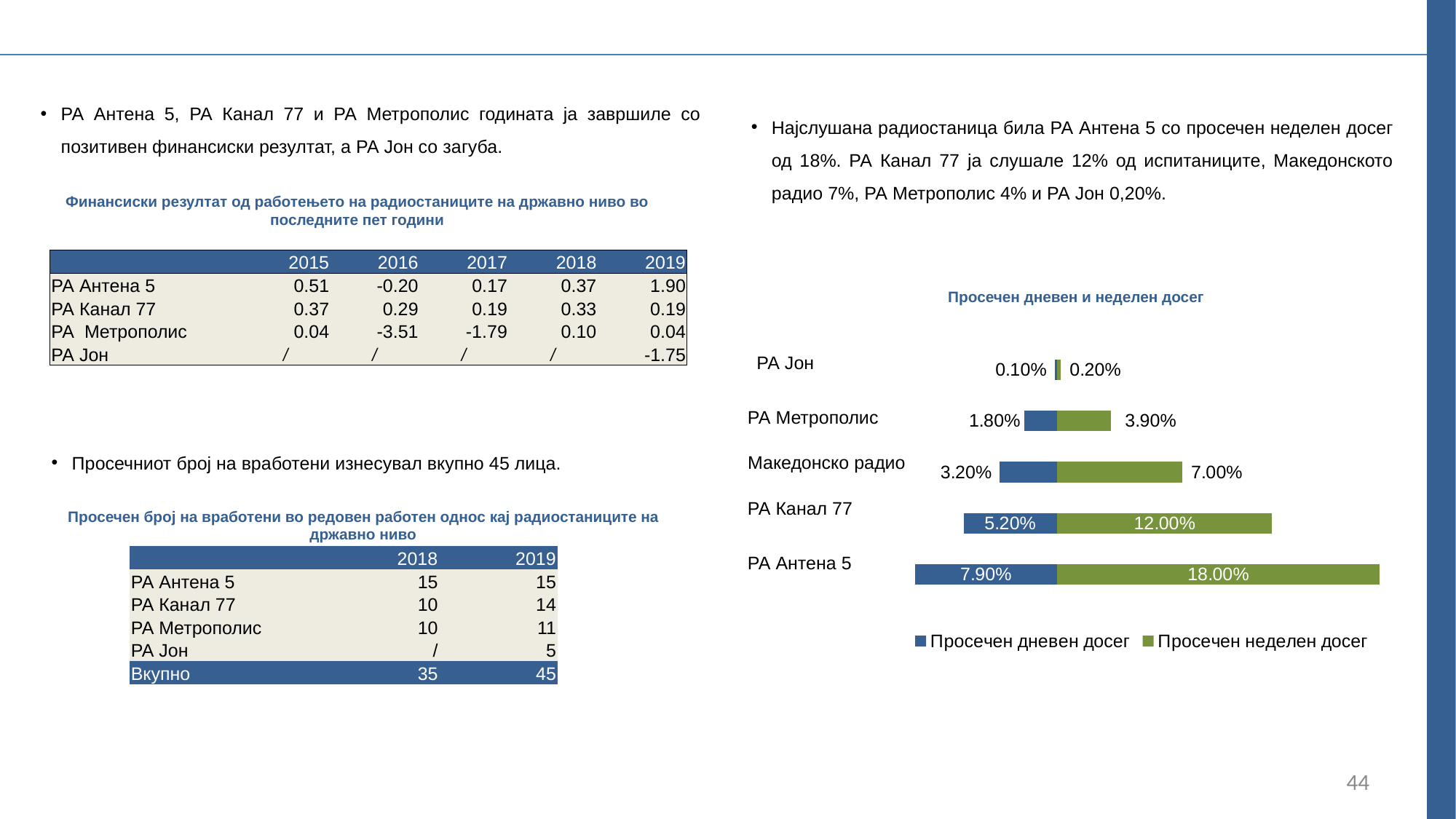
In the "Просечен дневен и неделен досег" chart, which colour represents Просечен неделен досег? green In the "Просечен дневен и неделен досег" chart, what is the difference between the Просечен неделен досег of РА Антена 5 and РА Канал 77? 6.00% In the "Просечен дневен и неделен досег" chart, what is the Просечен дневен досег for Македонско радио? 3.20% In the "Просечен дневен и неделен досег" chart, what is the total of the stacked bar for РА Канал 77? 17.20% How many radio stations are shown in the "Просечен дневен и неделен досег" chart? 5 What type of chart is "Просечен дневен и неделен досег"? bar chart In the "Просечен дневен и неделен досег" chart, which station has the highest Просечен неделен досег? РА Антена 5 In the "Просечен дневен и неделен досег" chart, which is larger: the Просечен дневен досег of РА Канал 77 or of Македонско радио? РА Канал 77 In the "Просечен дневен и неделен досег" chart, what is the Просечен неделен досег for РА Антена 5? 18.00% In the "Просечен дневен и неделен досег" chart, what is the Просечен неделен досег for РА Метрополис? 3.90% In the "Просечен дневен и неделен досег" chart, which station has the lowest Просечен дневен досег? РА Јон How many series does the legend of the "Просечен дневен и неделен досег" chart list? 2